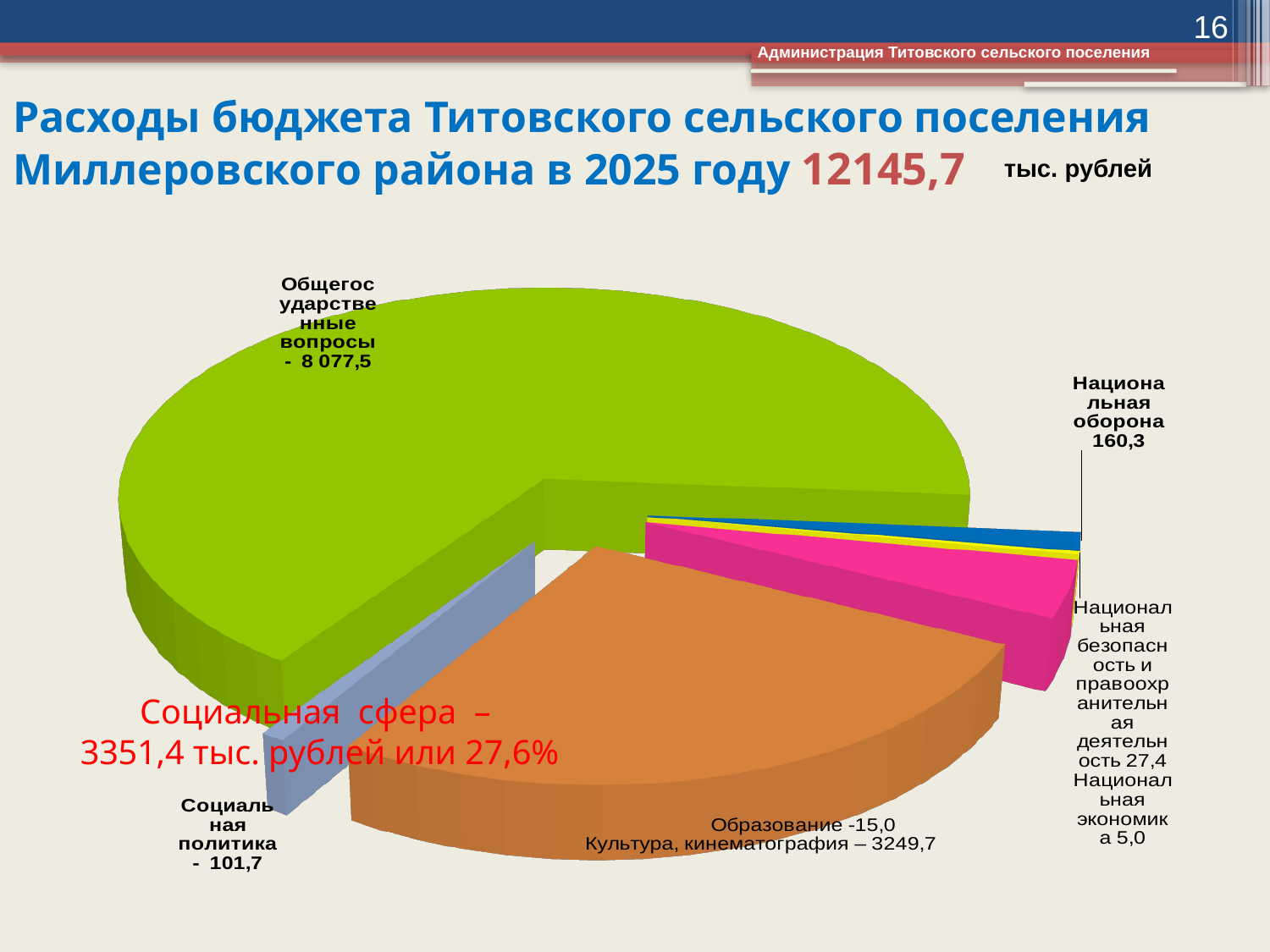
Which is larger, Национальная оборона or Социальная политика? Национальная оборона What is the value for Общегосударственные вопросы? 8 077,5 What kind of chart is shown on the slide? pie chart What is the value for Социальная политика? 101,7 Which category has the smallest value? Национальная экономика What is the value for Национальная оборона? 160,3 What is the value for Национальная экономика? 5,0 Which category has the largest slice of the pie? Общегосударственные вопросы What is the value for Культура, кинематография? 3249,7 What is the difference between Национальная оборона (160,3) and Социальная политика (101,7)? 58,6 What is the value for Образование? 15,0